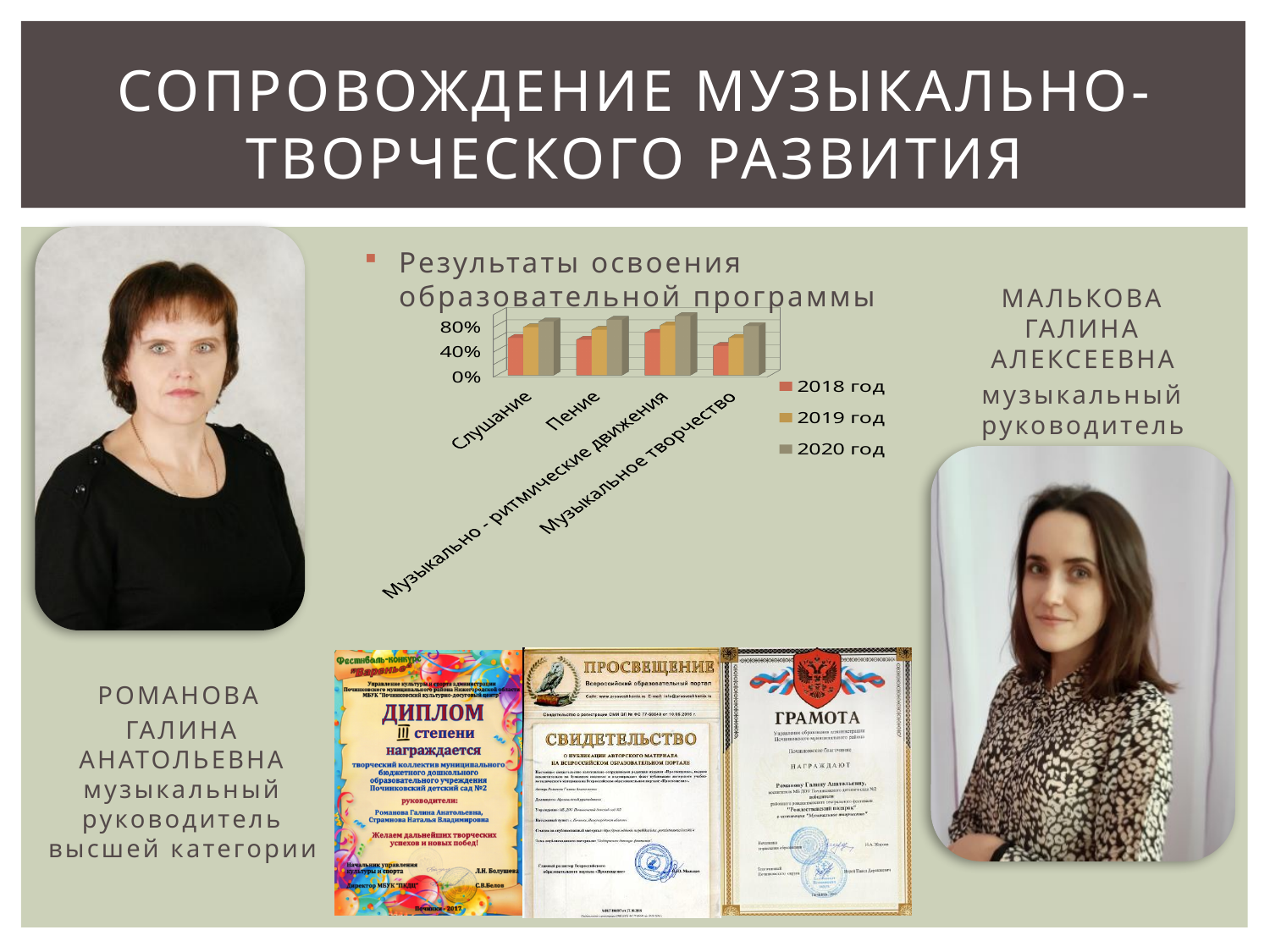
How many categories are shown on the x axis of the chart? 4 Is the value for 2018 год in the category Слушание greater or less than 40%? greater In the category Пение, which series has the larger value: 2018 год or 2020 год? 2020 год Is the value for 2018 год in the category Музыкальное творчество greater or less than 80%? less What kind of chart is shown on the slide? bar chart How many series does the chart legend list? 3 What is the title of the bulleted text above the chart? Результаты освоения образовательной программы Which series has the highest value in the category Музыкальное творчество? 2020 год Is the value for 2020 год in the category Музыкальное творчество greater or less than 40%? greater Which years are listed in the chart legend? 2018 год, 2019 год, 2020 год Within the category Музыкально - ритмические движения, do the values rise or fall from 2018 год to 2020 год? rise In the category Слушание, which series has the larger value: 2018 год or 2019 год? 2019 год